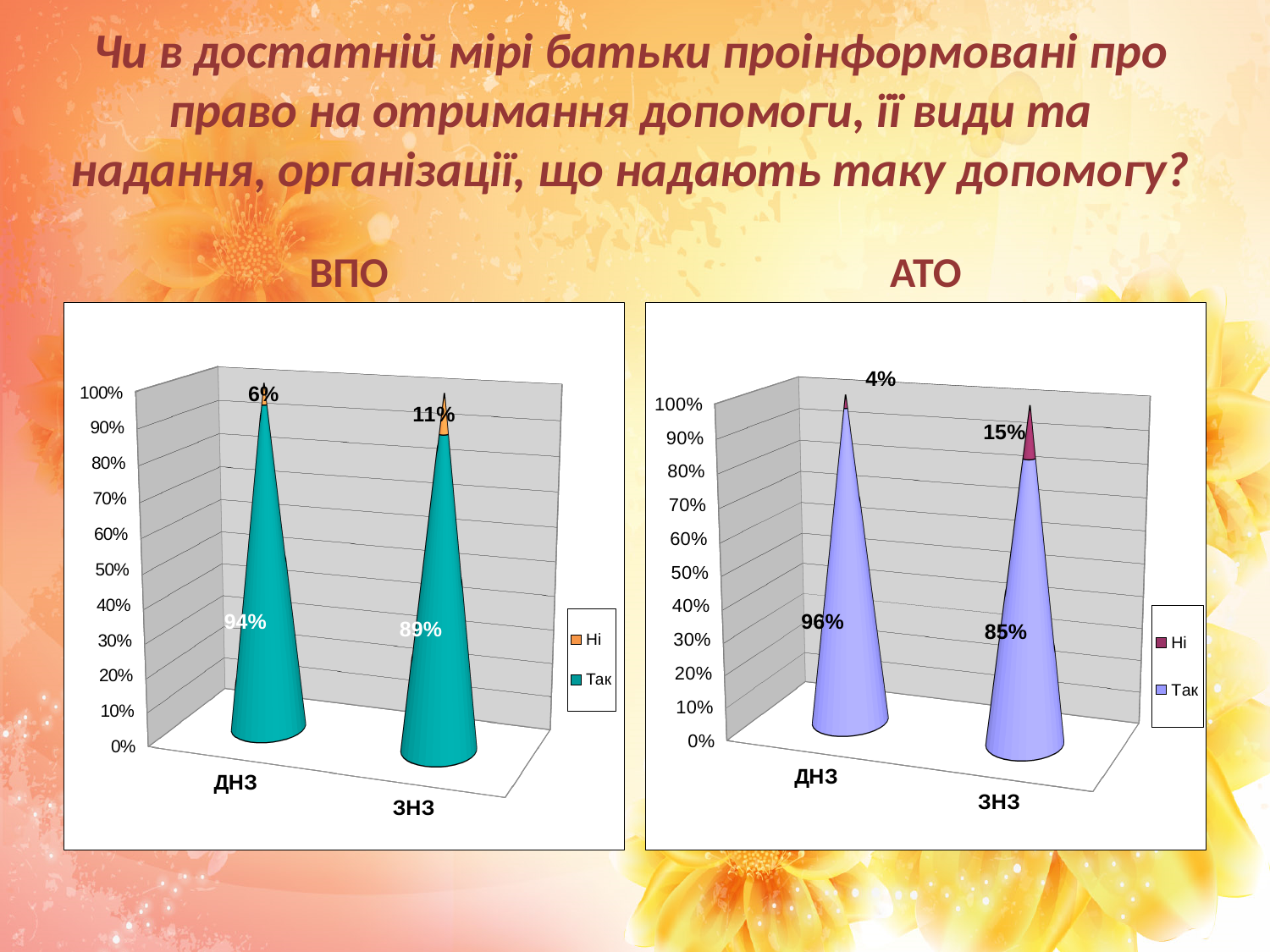
In the ВПО chart, what is the value of Так for ДНЗ? 94% In the АТО chart, what is the value of Так for ЗНЗ? 85% How many series does the legend of the АТО chart list? 2 In the АТО chart, what is the value of Ні for ДНЗ? 4% What are the legend entries in the ВПО chart? Ні, Так In the ВПО chart, which category has the lower value for Так? ЗНЗ How many categories are shown on the x axis of the ВПО chart? 2 Is the Так value for ДНЗ in the АТО chart larger or smaller than the Так value for ДНЗ in the ВПО chart? larger In the АТО chart, what is the difference between the Ні values for ЗНЗ and ДНЗ? 11% In the ВПО chart, what is the difference between the Так values for ДНЗ and ЗНЗ? 5% In the ВПО chart, what is the value of Ні for ЗНЗ? 11% In the АТО chart, which category has the higher value for Ні? ЗНЗ